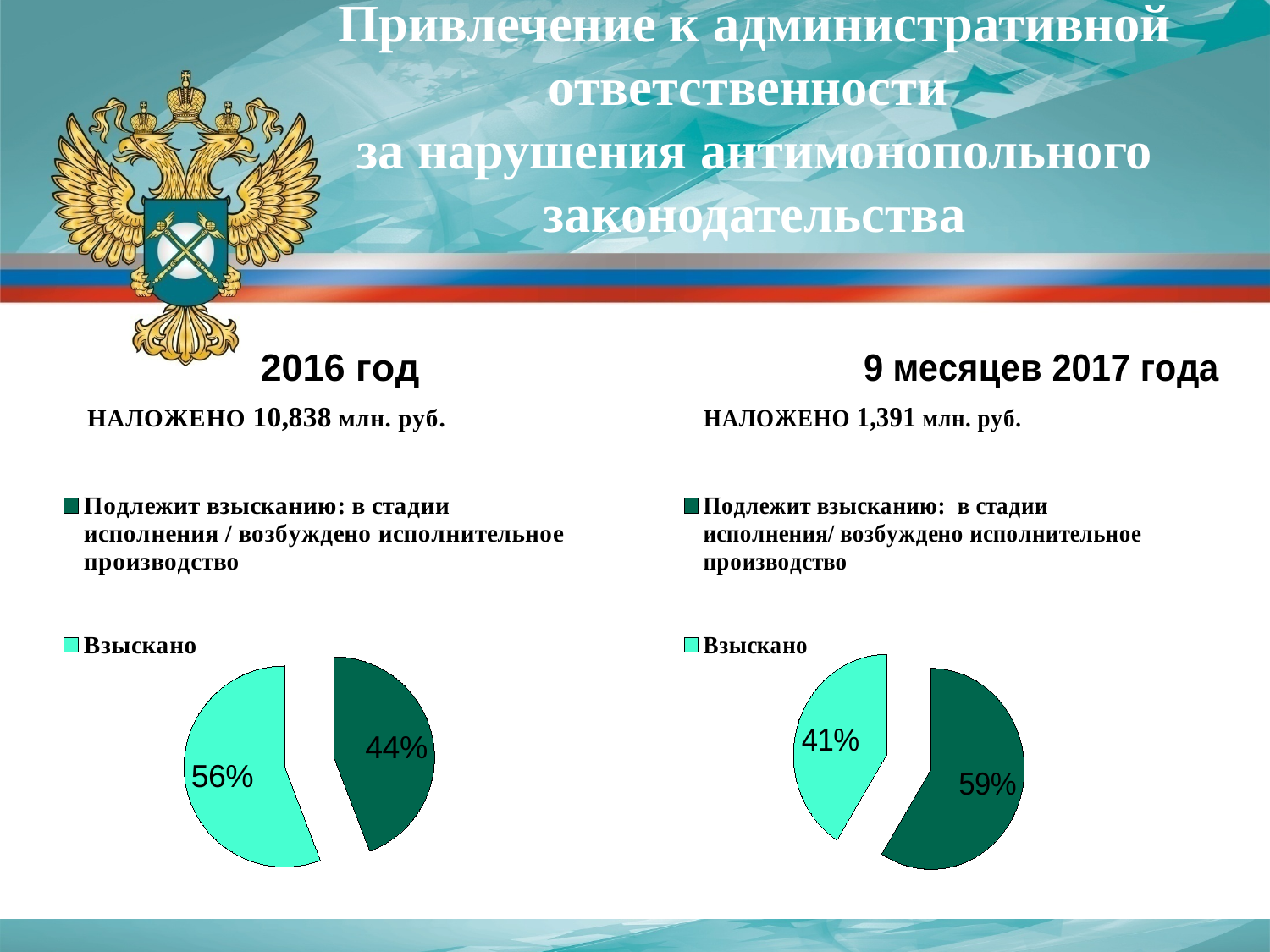
In the 2016 год chart, which slice is larger: Взыскано or Подлежит взысканию? Взыскано How many slices does the 9 месяцев 2017 года pie chart have? 2 What amount is stated as НАЛОЖЕНО above the 2016 год chart? 10,838 млн. руб. What is the difference between the two slices in the 2016 год chart? 12% What is the difference between the two slices in the 9 месяцев 2017 года chart? 18% Is the Взыскано share larger in the 2016 год chart or in the 9 месяцев 2017 года chart? 2016 год In the 9 месяцев 2017 года chart, which slice is smaller: Взыскано or Подлежит взысканию? Взыскано In the 2016 год chart, what share is labelled Подлежит взысканию: в стадии исполнения / возбуждено исполнительное производство? 44% In the 2016 год chart, what share is labelled Взыскано? 56% In the 9 месяцев 2017 года chart, what share is labelled Взыскано? 41% In the 9 месяцев 2017 года chart, what share is labelled Подлежит взысканию: в стадии исполнения/ возбуждено исполнительное производство? 59% What kind of chart is used on the slide for 2016 год? pie chart